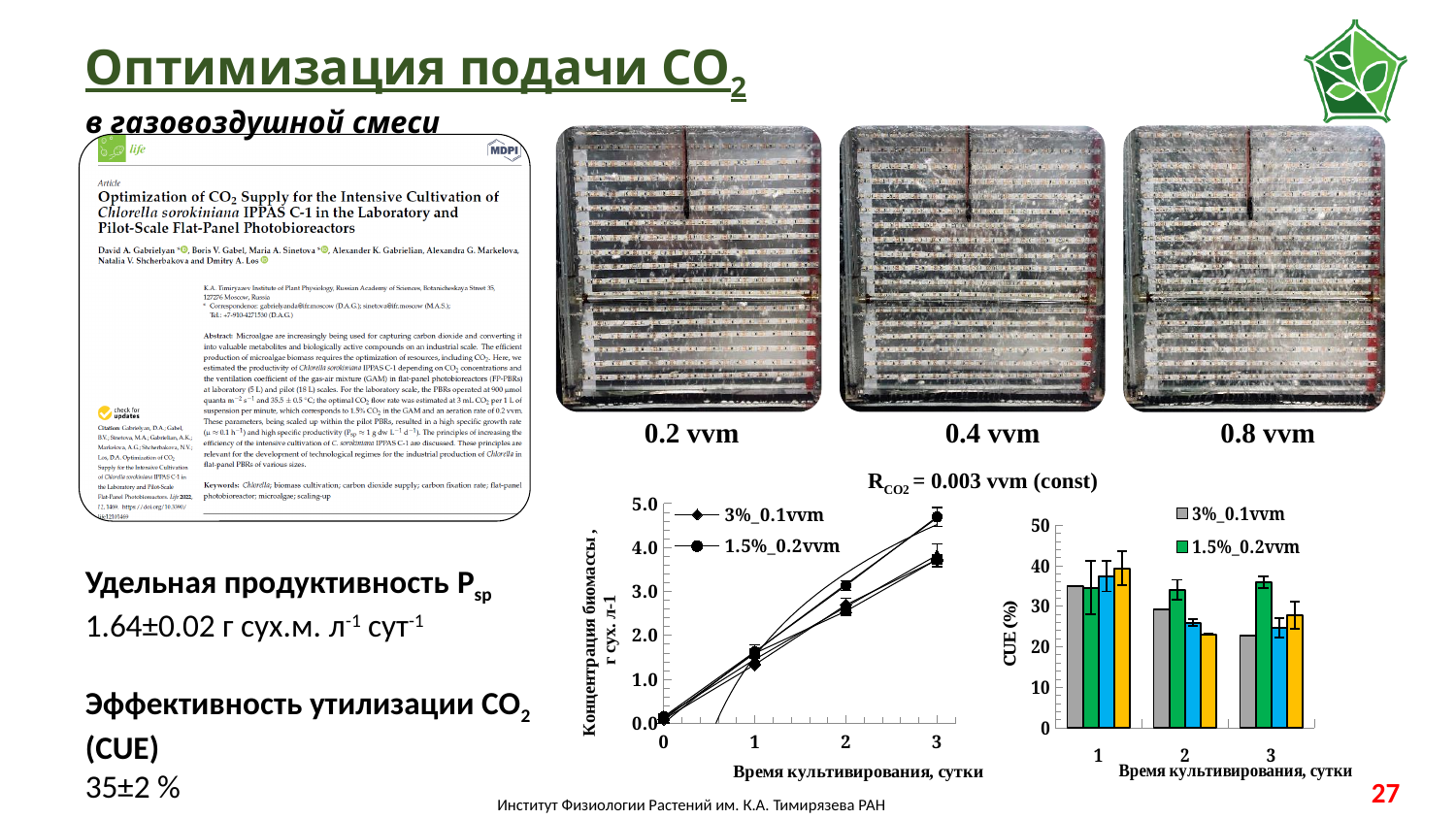
How many series does the legend of the right CUE (%) chart list? 2 What kind of chart is the right chart showing CUE (%)? Bar chart In the right CUE (%) chart, which series has the larger value at day 3: 3%_0.1vvm or 1.5%_0.2vvm? 1.5%_0.2vvm In the left biomass concentration chart, do the plotted values rise or fall as cultivation time increases from day 0 to day 3? Rise What kind of chart is the left chart showing biomass concentration over cultivation time? Line chart In the right CUE (%) chart, do the values for 3%_0.1vvm rise or fall from day 1 to day 3? Fall How many series does the legend of the left biomass concentration chart list? 2 What is the y-axis label of the right bar chart? CUE (%) In the right CUE (%) chart, is the value for 3%_0.1vvm at day 1 greater or less than 30? Greater In the right CUE (%) chart, is the value for 3%_0.1vvm at day 3 greater or less than 30? Less In the left biomass concentration chart, is the highest value plotted at day 3 greater or less than 4.0? Greater How many cultivation-day categories are shown on the x axis of the right CUE (%) chart? 3